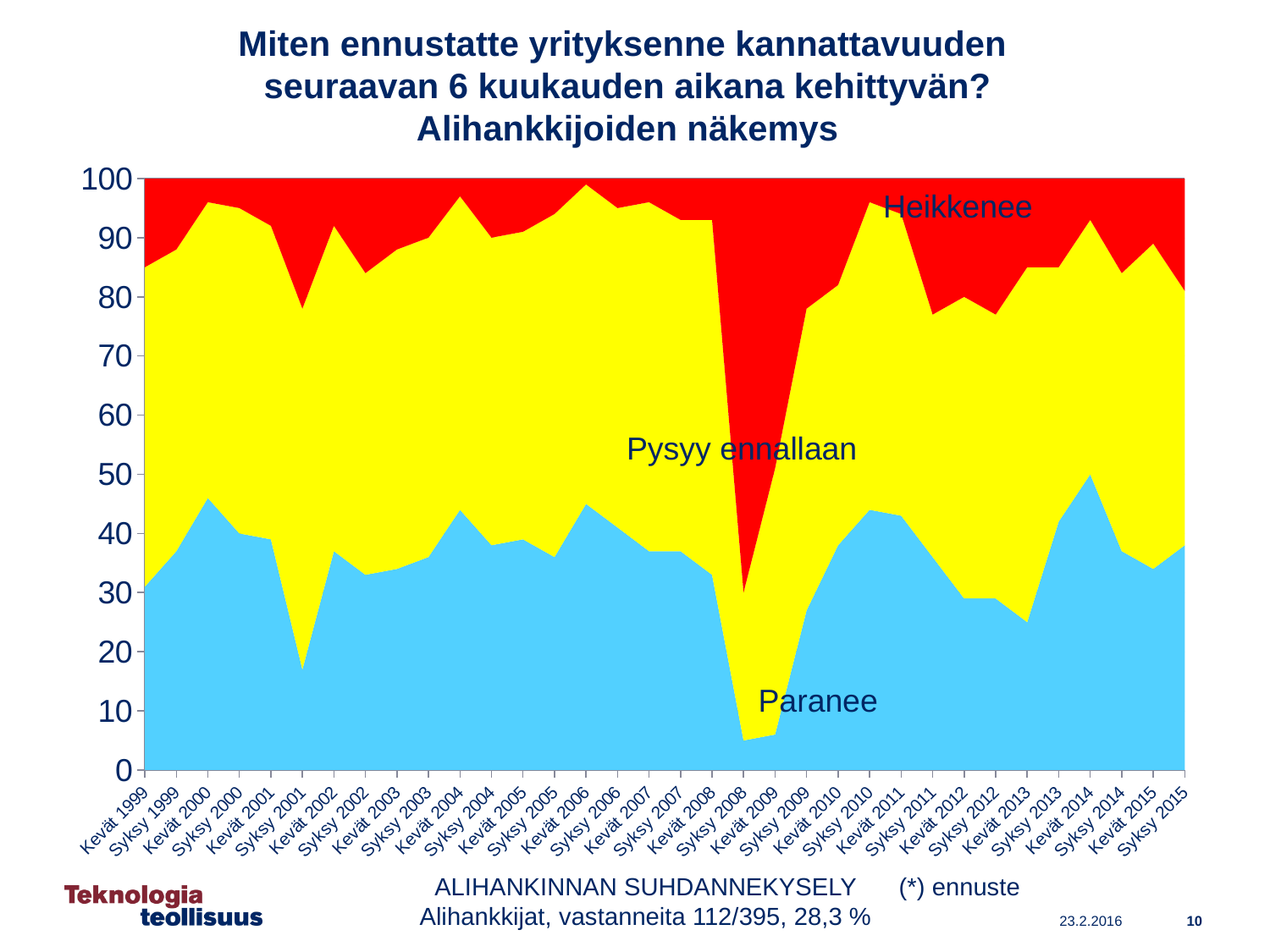
What kind of chart is shown on the slide? Stacked area chart What are the names of the three series labelled in the chart? Paranee, Pysyy ennallaan, Heikkenee Does the Paranee share rise or fall from Kevät 2008 to Syksy 2008? fall How many time points are shown on the x axis? 34 Is the Paranee value for Syksy 2001 greater or less than 20? less At which time point is the Paranee share lowest? Syksy 2008 How many series are shown in the chart? 3 Which series is shown in red? Heikkenee Is the Heikkenee value for Syksy 2008 greater or less than 60? greater Is the Paranee value for Kevät 2000 greater or less than 40? greater